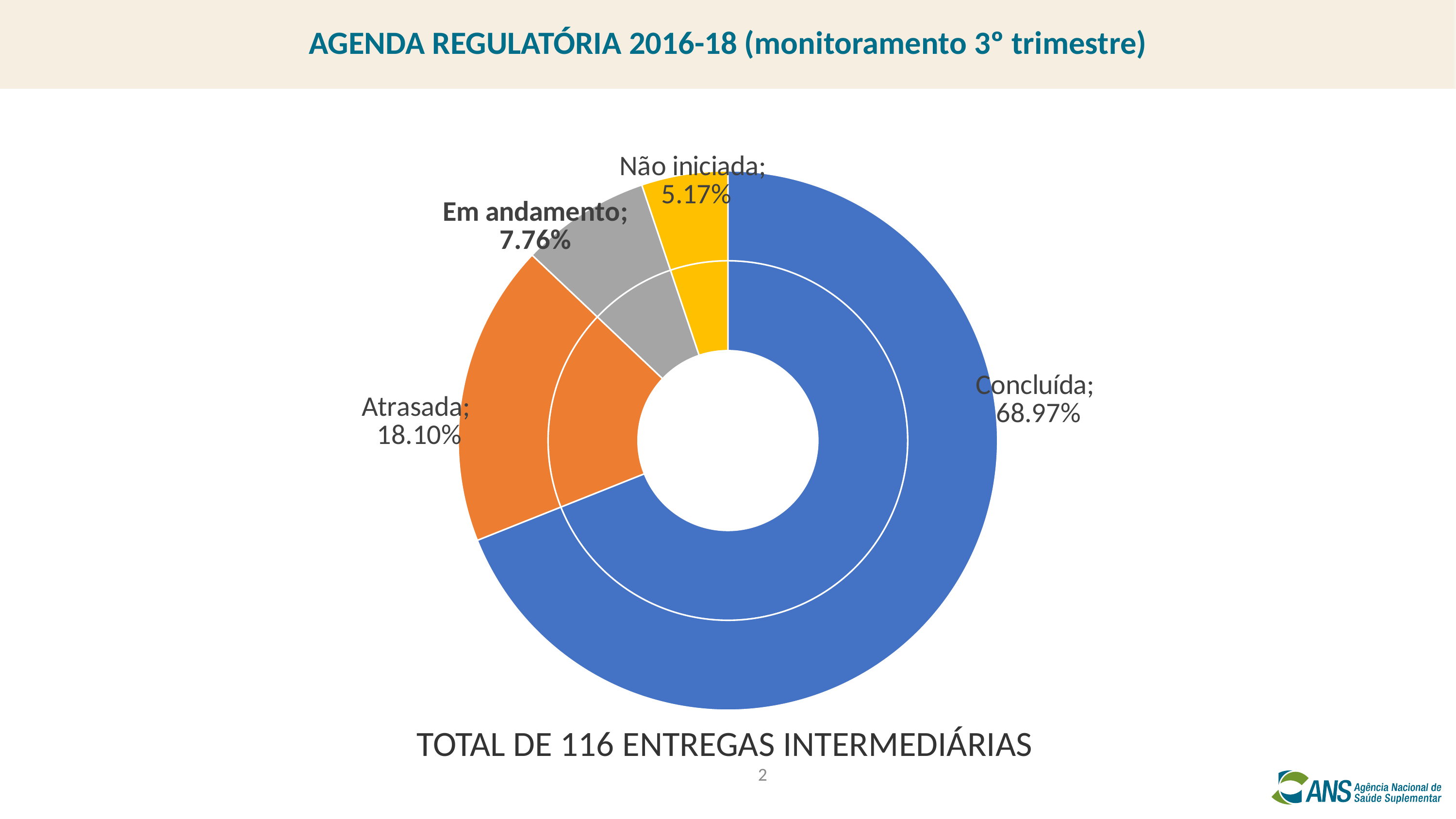
What percentage of deliveries is labelled Não iniciada? 5.17% What kind of chart is shown on the slide? Doughnut (pie) chart What is the combined share of Em andamento and Não iniciada? 12.93% Which category has the largest share of the chart? Concluída What percentage of deliveries is labelled Atrasada? 18.10% Which category has the smallest share of the chart? Não iniciada How many categories are shown in the chart? 4 What is the difference in percentage points between Concluída and Atrasada? 50.87 What percentage of deliveries is labelled Concluída? 68.97% Which is larger, the share for Em andamento or the share for Não iniciada? Em andamento What total number of intermediate deliveries is stated below the chart? 116 What percentage of deliveries is labelled Em andamento? 7.76%